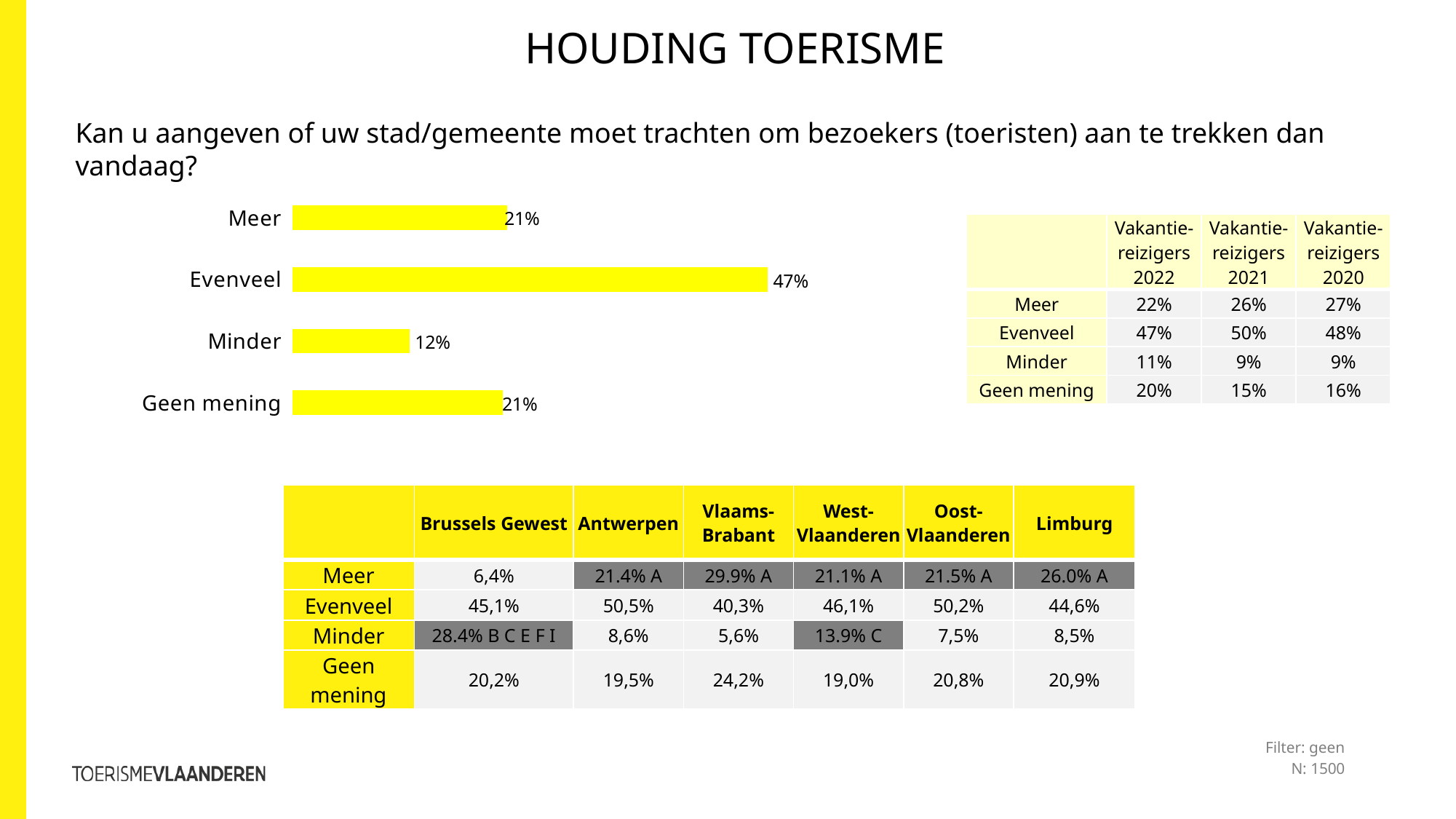
How many categories are shown in the bar chart? 4 What kind of chart is shown on the slide? Bar chart Which category has the highest value in the bar chart? Evenveel What is the value for Geen mening in the bar chart? 21% Which is larger in the bar chart, the value for Geen mening or the value for Minder? Geen mening Which is larger in the bar chart, the value for Evenveel or the value for Meer? Evenveel What is the value for Evenveel in the bar chart? 47% What is the difference between the values for Evenveel and Meer in the bar chart? 26% What is the value for Minder in the bar chart? 12% Which category has the lowest value in the bar chart? Minder What is the difference between the values for Evenveel and Minder in the bar chart? 35% What is the value for Meer in the bar chart? 21%